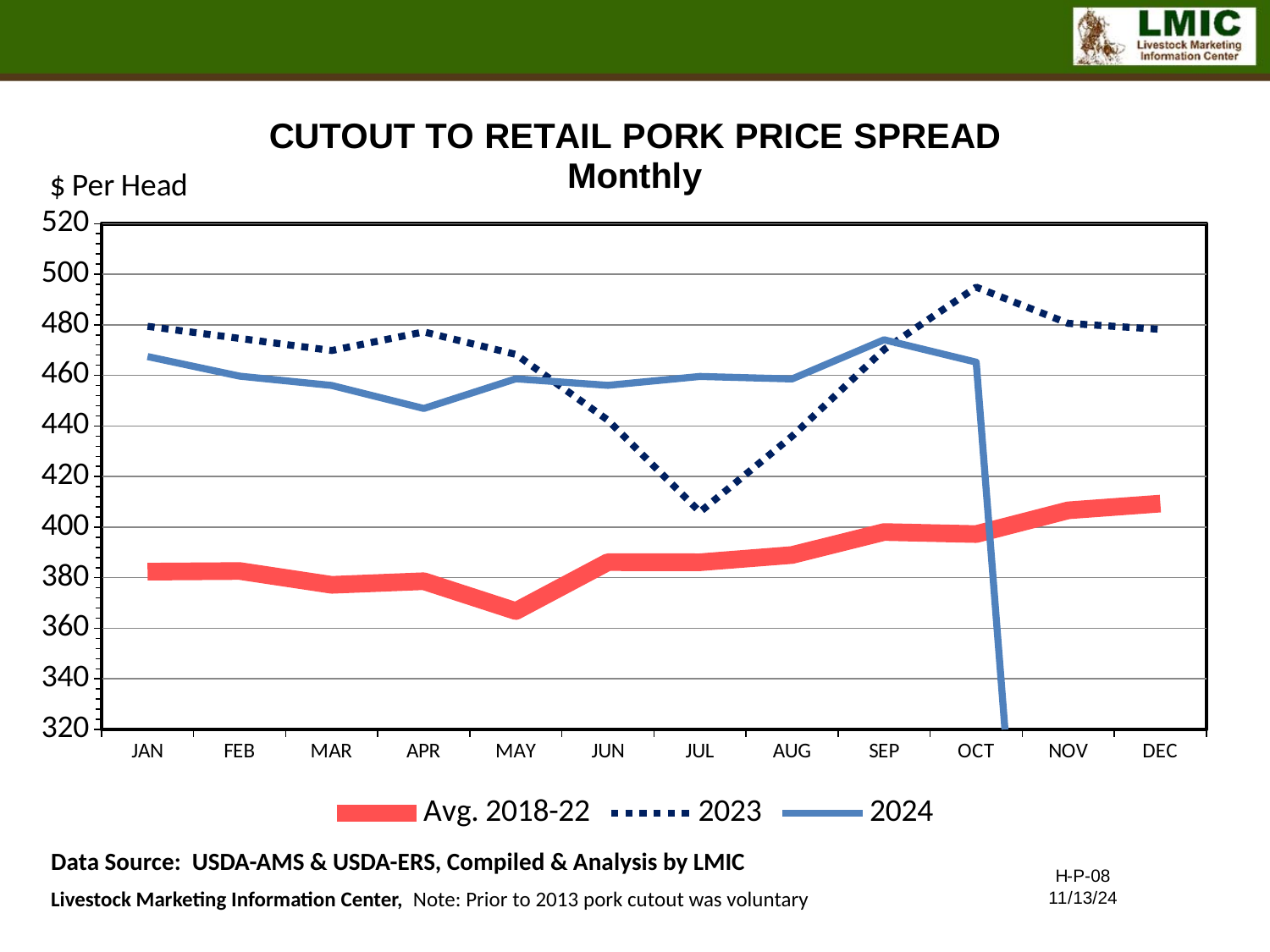
In JAN, which series has the larger value, 2023 or 2024? 2023 In which month does the 2023 series reach its highest value? OCT In which month is the Avg. 2018-22 series at its lowest? MAY How many months are plotted along the x axis? 12 In which month does the 2023 series reach its lowest value? JUL Is the 2023 value for JUL greater or less than 420? less How many series does the legend list? 3 In JUL, which series has the larger value, 2023 or 2024? 2024 Is the Avg. 2018-22 value for MAY greater or less than 380? less What unit is shown on the y axis of the chart? $ Per Head Is the 2023 value for OCT greater or less than 480? greater What kind of chart is shown on the slide? Line chart